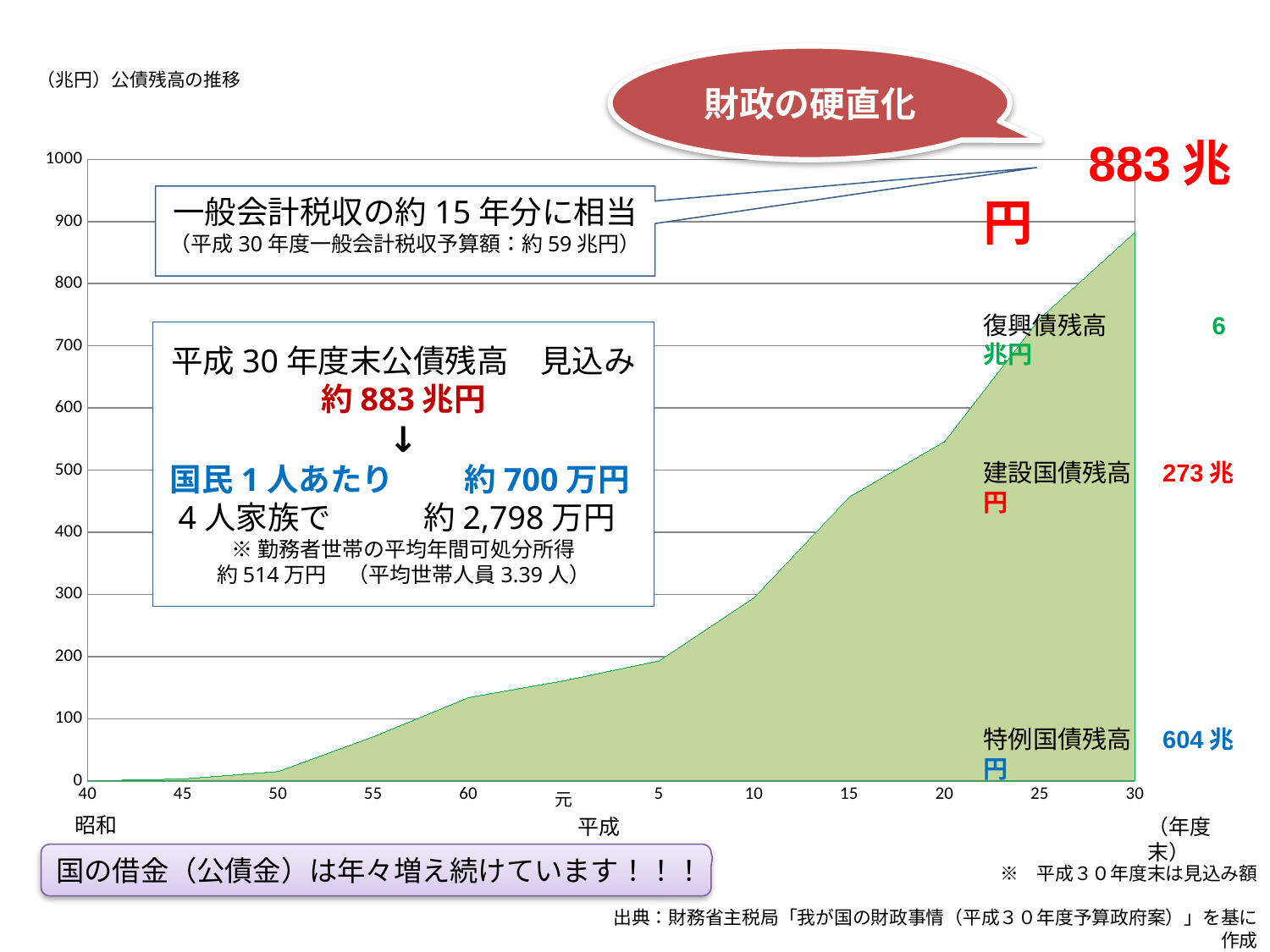
Does the public debt outstanding rise or fall over time along the x axis? rise What is the value shown for 特例国債残高 (special deficit-financing bonds outstanding)? 604兆円 What is the difference between 特例国債残高 (604兆円) and 建設国債残高 (273兆円)? 331兆円 Is the public debt outstanding at Showa 50 (昭和50) greater or less than 100? less What is the projected public debt outstanding at the end of Heisei 30 (平成30年度末) shown on the chart? 883兆円 What is the value shown for 復興債残高 (reconstruction bonds outstanding)? 6兆円 Which is larger, 特例国債残高 or 建設国債残高? 特例国債残高 What is the highest value labelled on the vertical axis of the chart? 1000 What is the value shown for 建設国債残高 (construction bonds outstanding)? 273兆円 What is the total of 復興債残高 (6兆円), 建設国債残高 (273兆円) and 特例国債残高 (604兆円)? 883兆円 Is the public debt outstanding at Heisei 20 (平成20) greater or less than 500? greater What kind of chart is used to show 公債残高の推移? area chart